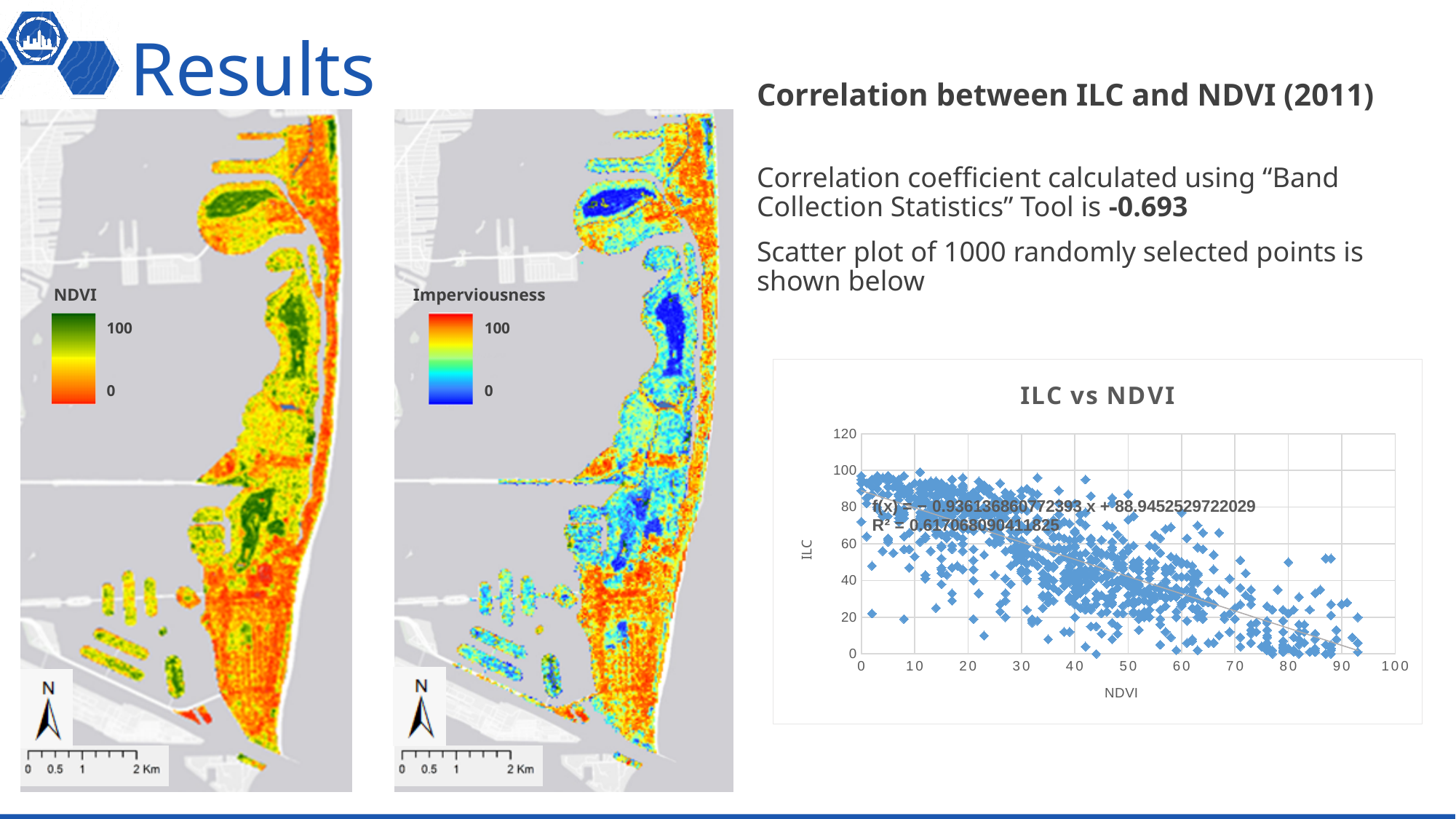
What is the label of the x axis of the "ILC vs NDVI" chart? NDVI What is the highest tick value on the x axis of the "ILC vs NDVI" chart? 100 What is the intercept of the trendline equation shown on the "ILC vs NDVI" chart? 88.9452529722029 In the "ILC vs NDVI" chart, do ILC values rise or fall as NDVI increases along the x axis? Fall What is the label of the y axis of the "ILC vs NDVI" chart? ILC What is the R² value shown on the "ILC vs NDVI" chart? 0.617068090411825 Is the slope of the trendline in the "ILC vs NDVI" chart positive or negative? Negative What is the slope of the trendline equation shown on the "ILC vs NDVI" chart? -0.936136860772393 What is the highest tick value on the y axis of the "ILC vs NDVI" chart? 120 What kind of chart is the "ILC vs NDVI" chart? Scatter plot Is the R² value shown on the "ILC vs NDVI" chart greater or less than 0.5? greater How many randomly selected points are plotted in the "ILC vs NDVI" scatter plot, according to the slide? 1000